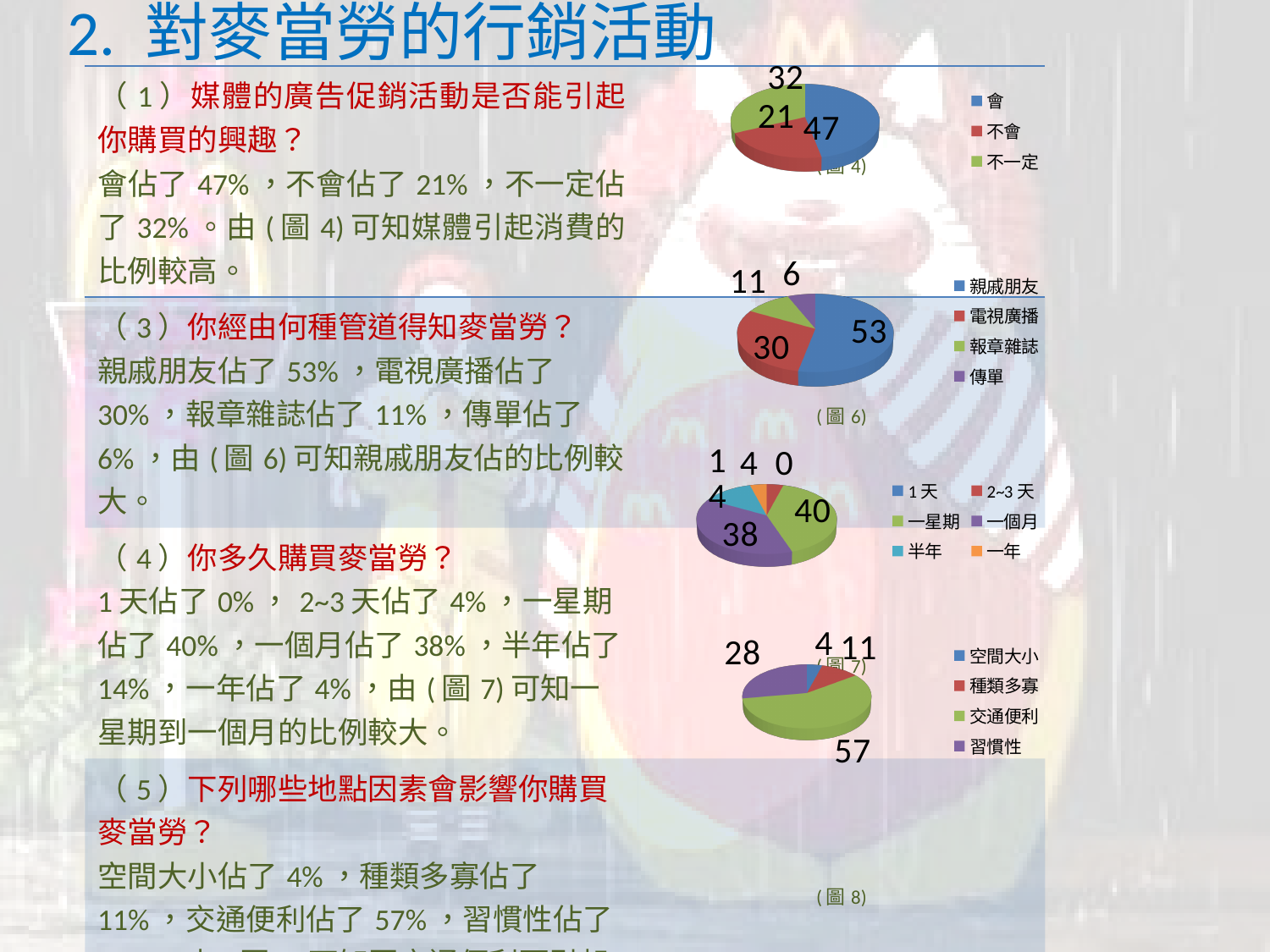
In the chart labelled (圖 8), which category has the smallest slice? 空間大小 In the chart labelled (圖 7), how many categories does the legend list? 6 In the chart labelled (圖 8), what is the value for 交通便利? 57 In the chart labelled (圖 7), which is larger, 一星期 or 一個月? 一星期 In the chart labelled (圖 7), what is the value for 一星期? 40 In the chart labelled (圖 4), what is the value for 會? 47 In the chart labelled (圖 6), what is the value for 電視廣播? 30 What type of chart is the chart labelled (圖 8)? Pie chart In the chart labelled (圖 6), how many categories does the legend list? 4 In the chart labelled (圖 6), which category has the largest slice? 親戚朋友 In the chart labelled (圖 4), which category has the smallest slice? 不會 In the chart labelled (圖 4), what is the difference between the values for 會 and 不一定? 15